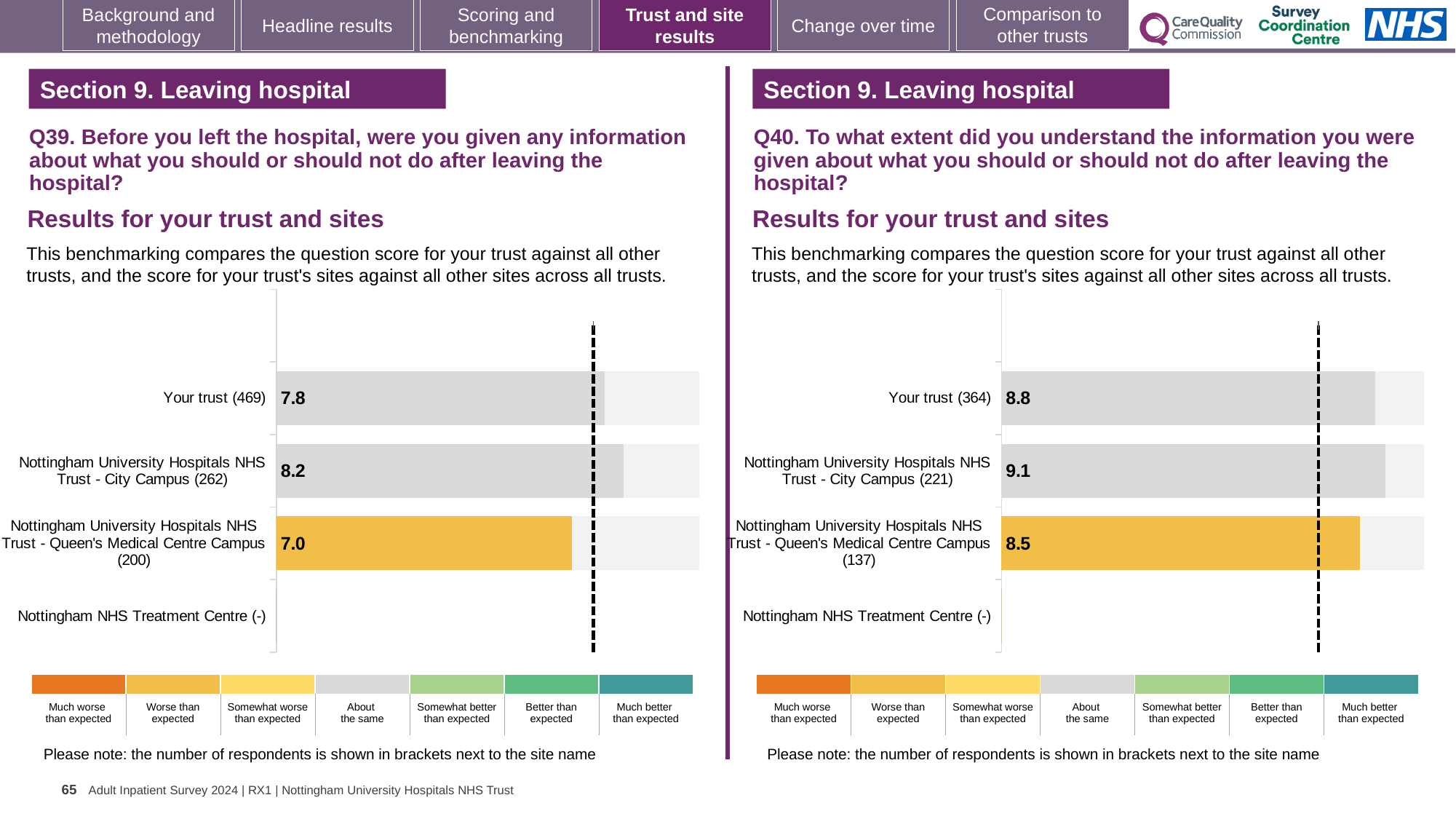
In the Q39 chart on the left, which site or trust row has the highest score? Nottingham University Hospitals NHS Trust - City Campus (262) In the Q40 chart on the right, what is the difference between the Your trust score and the Queen's Medical Centre Campus score? 0.3 In the Q40 chart on the right, what is the score for Your trust (364)? 8.8 In the Q39 chart on the left, which benchmark category does the colour of the Queen's Medical Centre Campus bar correspond to? Worse than expected In the Q40 chart on the right, what is the score for Nottingham University Hospitals NHS Trust - City Campus (221)? 9.1 What kind of chart is used on the left for Q39? Bar chart In the Q40 chart on the right, which is larger: the score for Your trust (364) or the score for City Campus (221)? City Campus (221) In the Q39 chart on the left, what is the score for Nottingham University Hospitals NHS Trust - Queen's Medical Centre Campus (200)? 7.0 In the Q40 chart on the right, which site or trust row has the lowest score? Nottingham University Hospitals NHS Trust - Queen's Medical Centre Campus (137) In the Q39 chart on the left, what is the score for Your trust (469)? 7.8 In the Q39 chart on the left, what is the difference between the City Campus score and the Queen's Medical Centre Campus score? 1.2 In the Q39 chart on the left, how many rows have a score bar plotted? 3